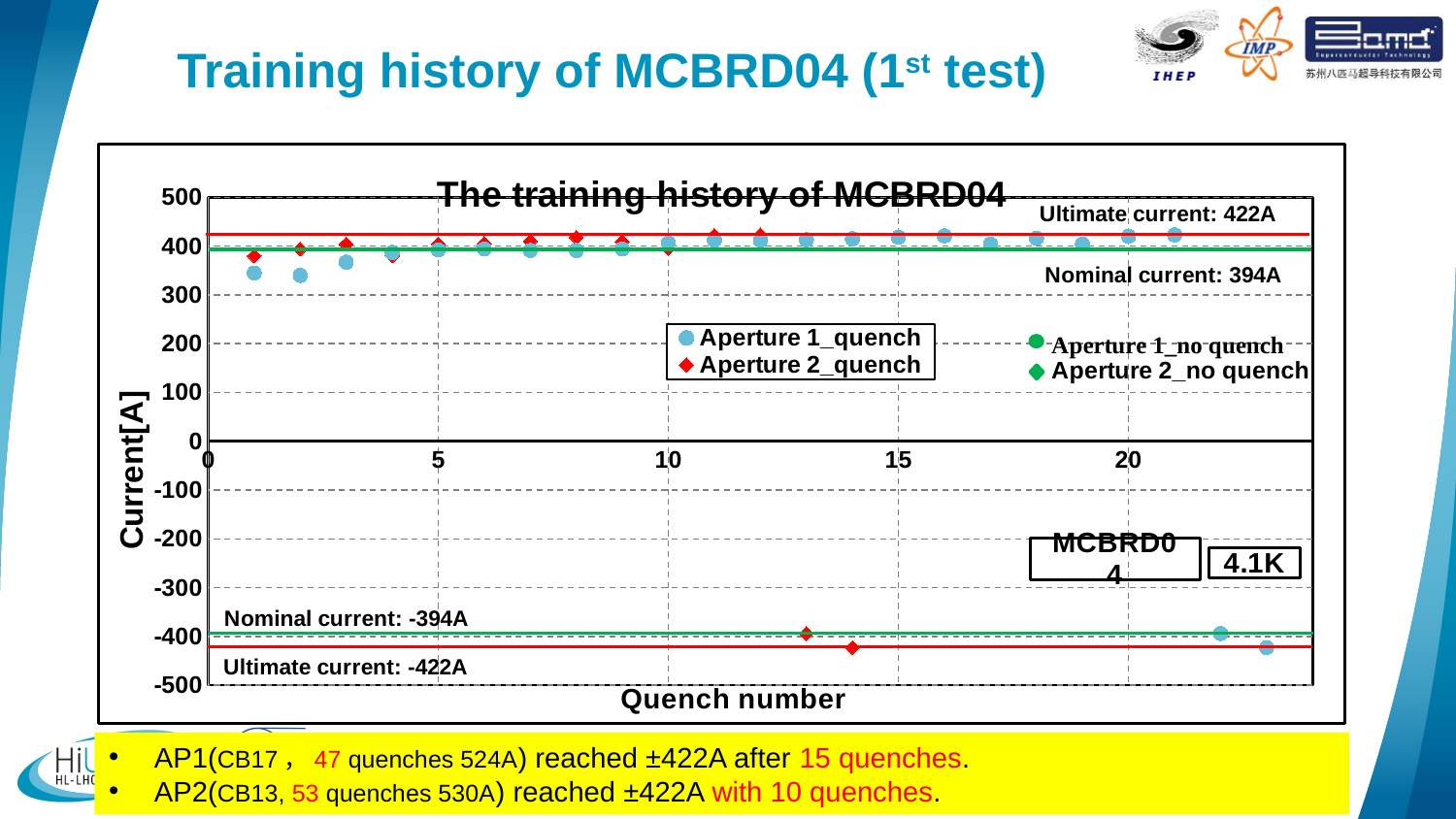
What is the label of the y axis of the chart? Current[A] How many series does the chart legend list? 4 What nominal current value is annotated on the chart for the negative direction? -394A What ultimate current value is annotated on the chart for the positive direction? 422A Is the Aperture 1_quench value at quench number 2 greater or less than 300? greater What is the title of the chart? The training history of MCBRD04 Is the Aperture 1_quench value at quench number 1 greater or less than 400? less Do the positive Aperture 1_quench values generally rise or fall as the quench number increases? rise What is the highest tick value shown on the y axis of the chart? 500 What nominal current value is annotated on the chart for the positive direction? 394A What kind of chart is shown on the slide? Scatter chart Is the Aperture 2_quench value at quench number 14 greater or less than -400? less